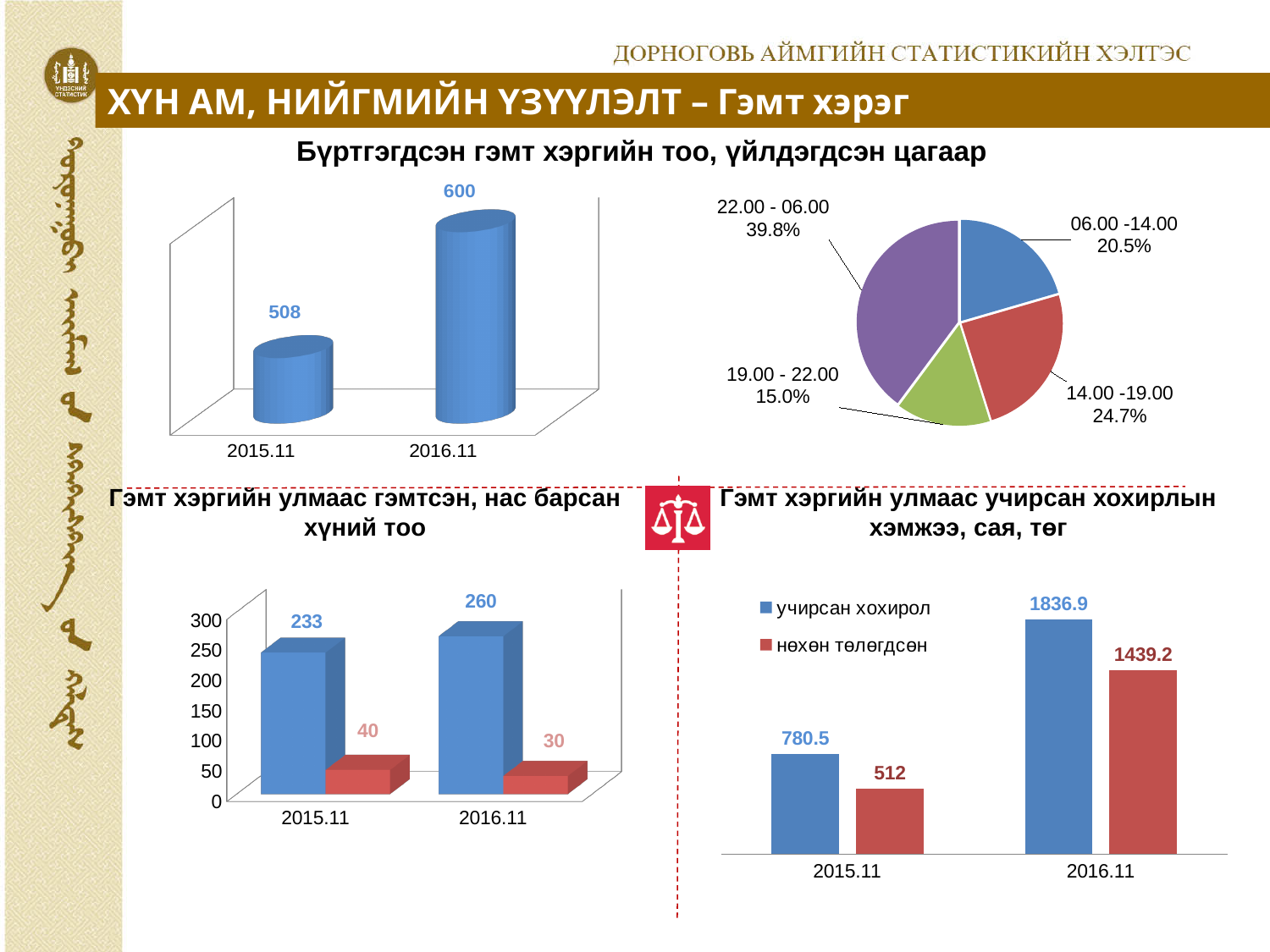
In the bottom-left bar chart (Гэмт хэргийн улмаас гэмтсэн, нас барсан хүний тоо), what is the value of the red bar for 2015.11? 40 In the bottom-right bar chart, how many series does the legend list? 2 In the top-right pie chart, how many slices are there? 4 In the top-left bar chart, do the values rise or fall from 2015.11 to 2016.11? rise What kind of chart is the top-right chart on the slide? pie chart In the top-left bar chart (Бүртгэгдсэн гэмт хэргийн тоо), what is the difference between the 2016.11 and 2015.11 values? 92 In the top-right pie chart, which time period has the smallest slice? 19.00 - 22.00 In the bottom-right bar chart, which is larger: учирсан хохирол in 2015.11 or нөхөн төлөгдсөн in 2016.11? нөхөн төлөгдсөн in 2016.11 In the top-right pie chart, what share does the 22.00 - 06.00 slice have? 39.8% In the bottom-left bar chart, is the blue bar for 2016.11 greater or less than 250? greater In the top-left bar chart (Бүртгэгдсэн гэмт хэргийн тоо), what is the value for 2016.11? 600 In the bottom-right bar chart (Гэмт хэргийн улмаас учирсан хохирлын хэмжээ), what is the value for нөхөн төлөгдсөн in 2016.11? 1439.2